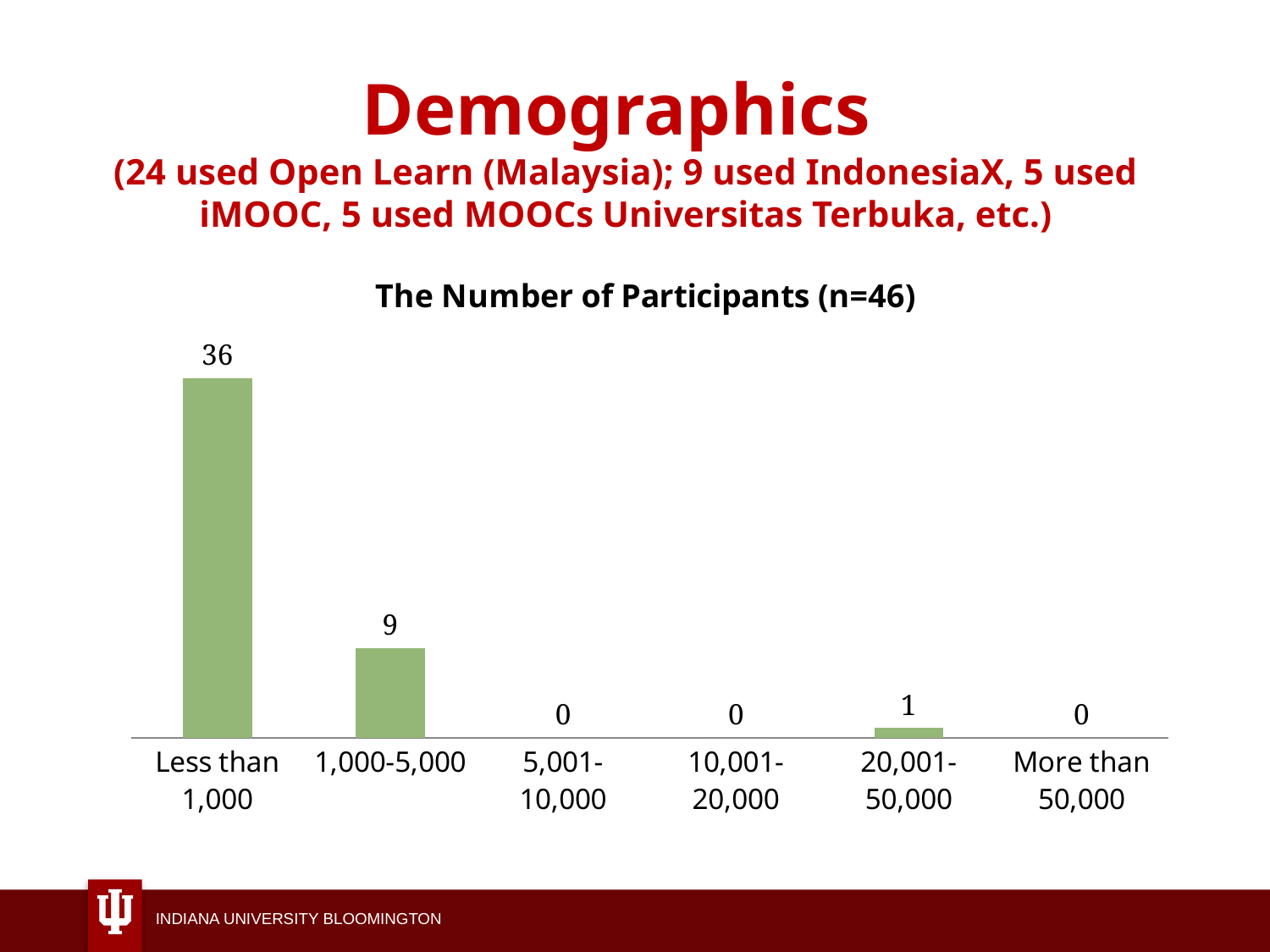
What is the title of the chart? The Number of Participants (n=46) What is the difference between the values for 'Less than 1,000' and '1,000-5,000'? 27 How many categories are shown on the x axis? 6 How many categories have a value of 0? 3 Which is larger, the value for '1,000-5,000' or the value for '20,001-50,000'? 1,000-5,000 What is the value for the 'Less than 1,000' category? 36 What is the value for the '20,001-50,000' category? 1 What is the value for the '1,000-5,000' category? 9 Which category has the highest value? Less than 1,000 What is the difference between the values for '1,000-5,000' and '20,001-50,000'? 8 What is the value for the '5,001-10,000' category? 0 What kind of chart is shown on the slide? Bar chart